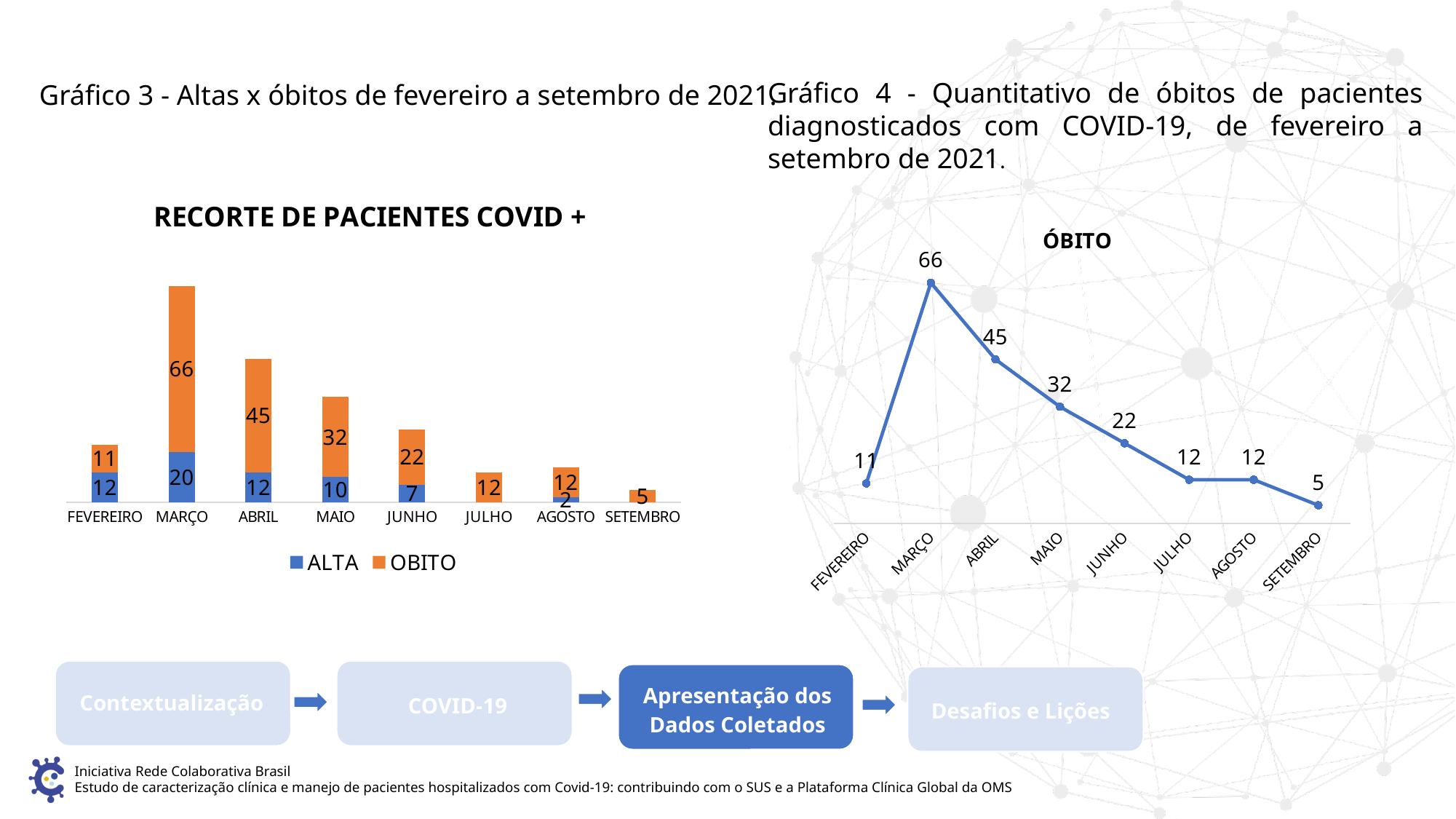
In the 'RECORTE DE PACIENTES COVID +' chart, what is the OBITO value for MARÇO? 66 In the 'RECORTE DE PACIENTES COVID +' chart, what is the ALTA value for FEVEREIRO? 12 In the 'ÓBITO' chart, do the values rise or fall from MARÇO to SETEMBRO? Fall In the 'RECORTE DE PACIENTES COVID +' chart, what is the difference between the OBITO values for MAIO and JUNHO? 10 In the 'ÓBITO' chart, which month has the lowest value? SETEMBRO In the 'RECORTE DE PACIENTES COVID +' chart, which month has the highest ALTA value? MARÇO In the 'RECORTE DE PACIENTES COVID +' chart, what is the total of the stacked bar for ABRIL? 57 In the 'ÓBITO' chart, what is the value for ABRIL? 45 In the 'ÓBITO' chart, how many months are plotted? 8 In the 'RECORTE DE PACIENTES COVID +' chart, what is the total of the stacked bar for MARÇO? 86 In the 'RECORTE DE PACIENTES COVID +' chart, how many series does the legend list? 2 What kind of chart is the 'ÓBITO' chart on the right? Line chart